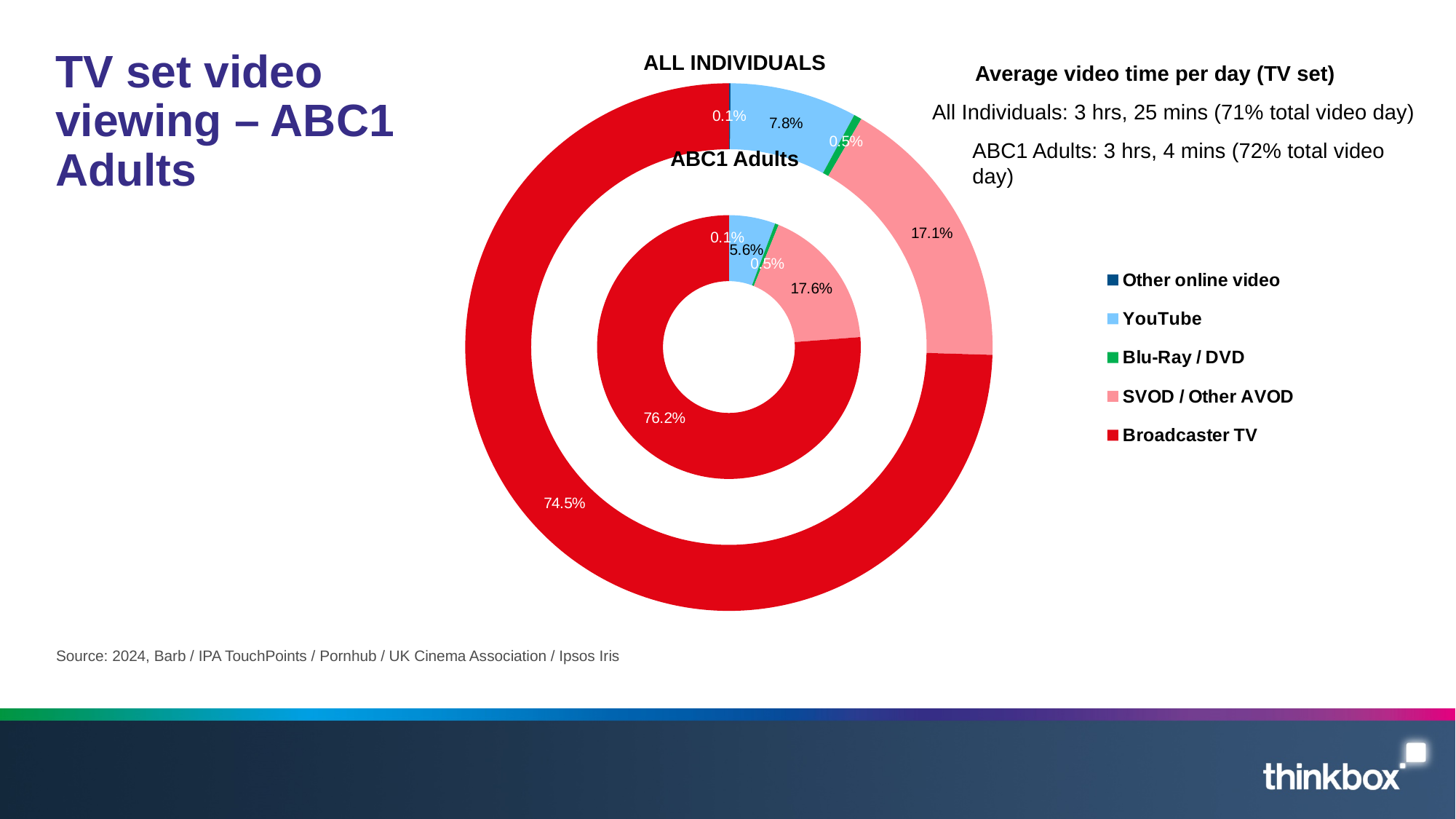
In the ABC1 Adults ring, what share is Broadcaster TV? 76.2% Which colour represents Blu-Ray / DVD in the chart? Green Is the YouTube share larger for ALL INDIVIDUALS or for ABC1 Adults? ALL INDIVIDUALS Which category has the largest share in the ALL INDIVIDUALS ring? Broadcaster TV Which category has the smallest share in the ABC1 Adults ring? Other online video What is the difference between the Broadcaster TV share for ABC1 Adults and for ALL INDIVIDUALS? 1.7% How many series does the legend list? 5 In the ALL INDIVIDUALS ring, what share is YouTube? 7.8% In the ABC1 Adults ring, what share is SVOD / Other AVOD? 17.6% What kind of chart is shown on the slide? Doughnut chart In the ALL INDIVIDUALS ring, what share is Broadcaster TV? 74.5% In the ABC1 Adults ring, what share is YouTube? 5.6%